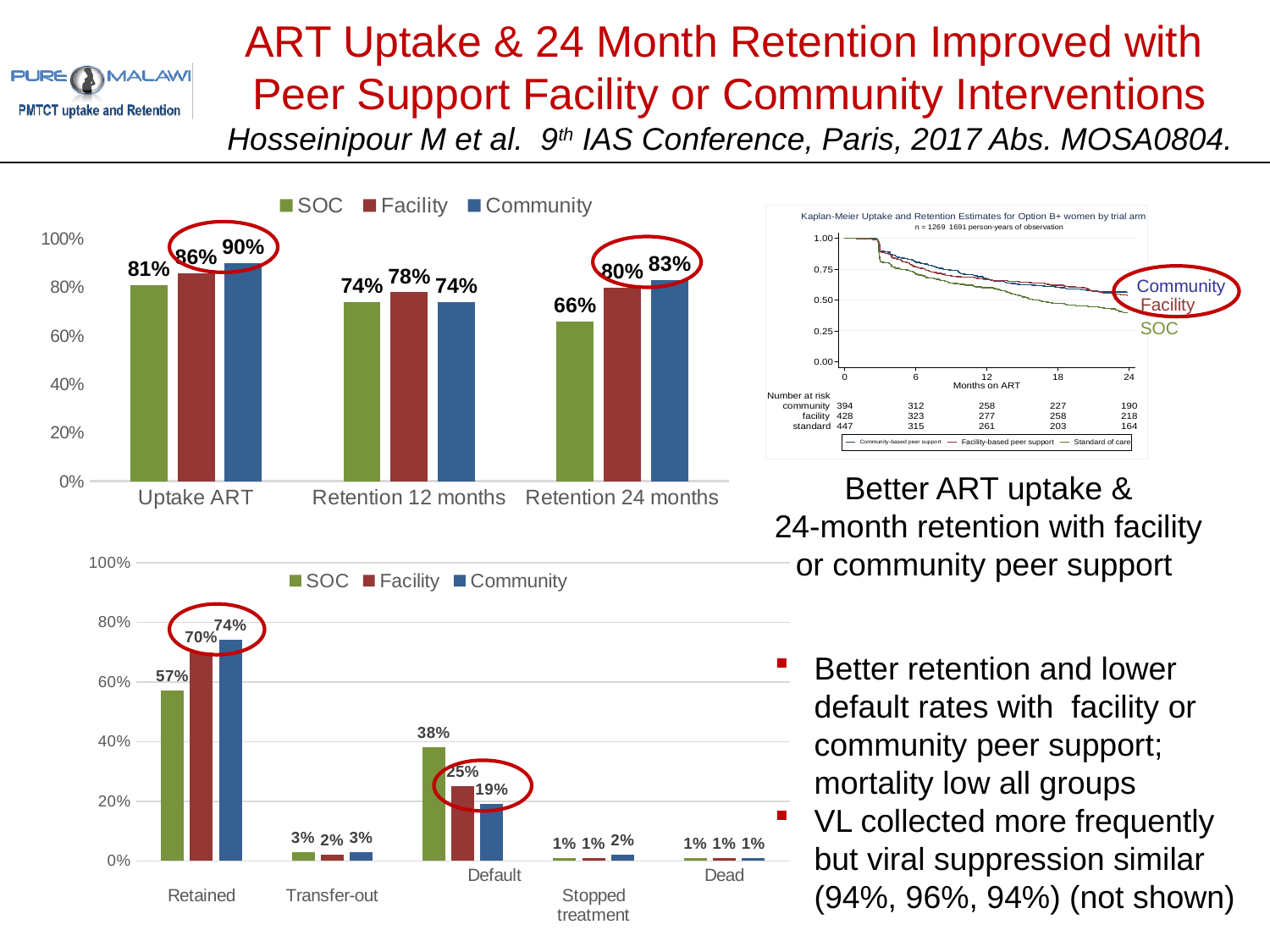
In the bottom-left bar chart, what is the value for SOC for Default? 38% In the bottom-left bar chart, is the SOC value for Default larger or smaller than the Community value for Default? larger In the top-left bar chart, what is the value for SOC for Retention 24 months? 66% In the top-left bar chart, what is the difference between the Community and SOC values for Retention 24 months? 17% In the bottom-left bar chart, which series has the highest value for Retained? Community In the top-left bar chart, which series has the lowest value for Retention 24 months? SOC In the bottom-left bar chart, what is the value for Facility for Retained? 70% In the top-left bar chart, how many series does the legend list? 3 In the top-left bar chart, how many categories are shown on the x axis? 3 What kind of chart is the bottom-left chart? bar chart In the top-left bar chart, what is the value for Community for Uptake ART? 90% In the bottom-left bar chart, what is the difference between the SOC and Community values for Default? 19%